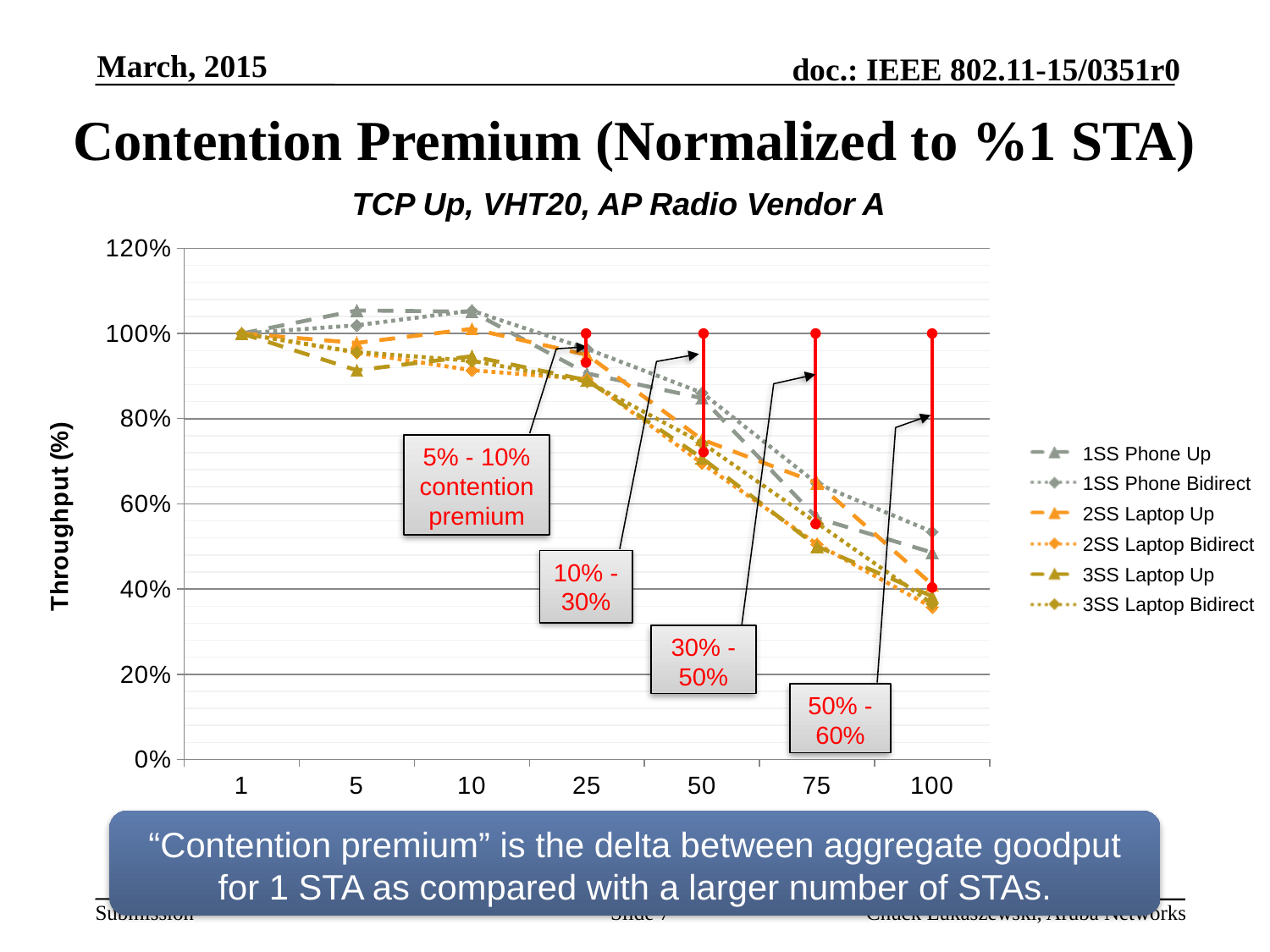
What is the value of 1SS Phone Up at x = 1? 100% What contention premium range does the annotation box at x = 100 show? 50% - 60% At x = 100, which is larger: 1SS Phone Bidirect or 3SS Laptop Up? 1SS Phone Bidirect Do the throughput values generally rise or fall as the number of STAs increases along the x axis? fall What kind of chart is shown on the slide? line chart Is the value for 3SS Laptop Up at x = 5 greater or less than 100%? less Is the value for 1SS Phone Up at x = 5 greater or less than 100%? greater Is the value for 3SS Laptop Up at x = 100 greater or less than 40%? less How many series does the legend list? 6 Which series has the highest value at x = 100? 1SS Phone Bidirect How many categories are shown on the x axis? 7